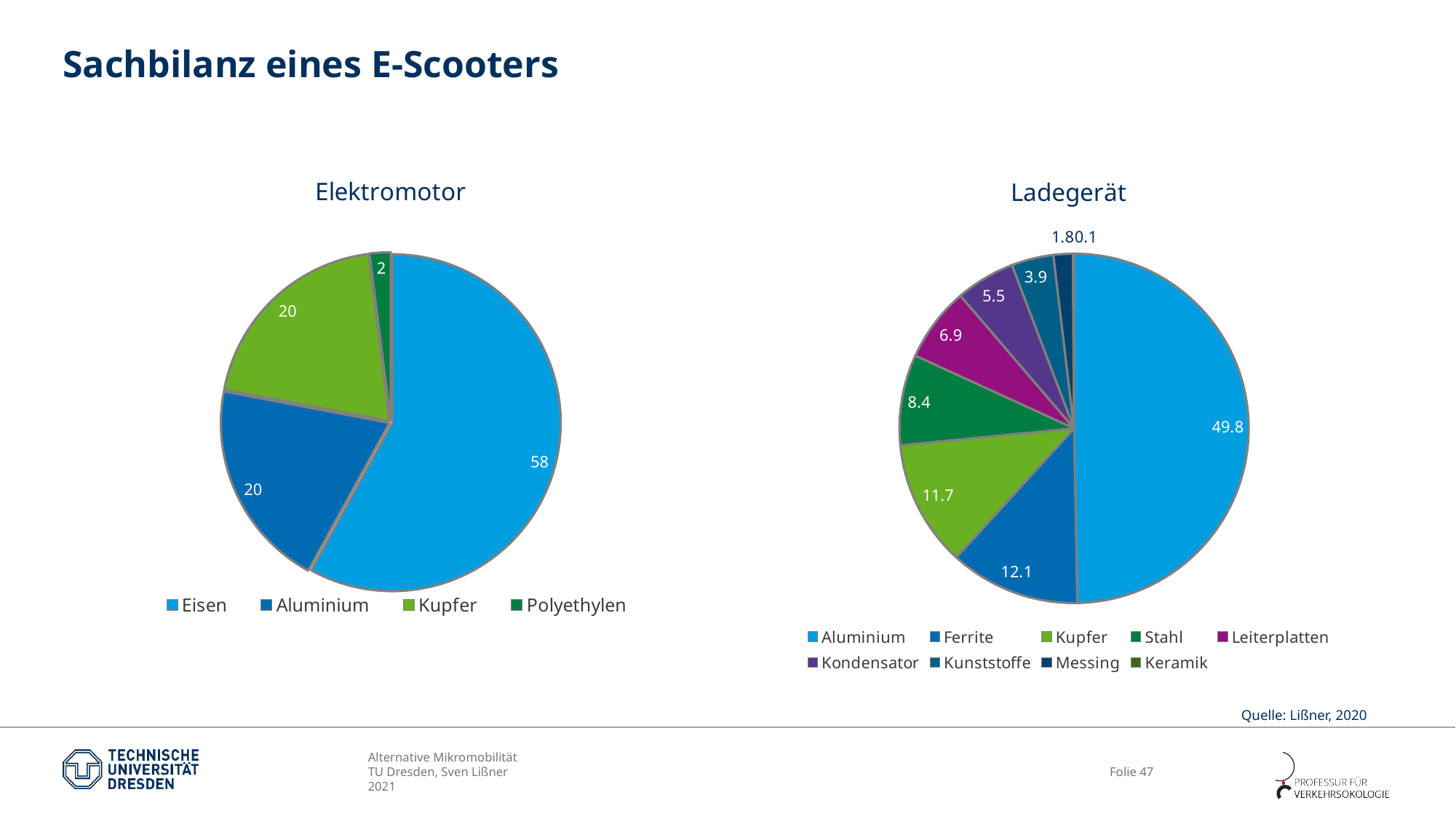
In the Elektromotor chart, which category has the smallest slice? Polyethylen In the Elektromotor chart, what is the value for Eisen? 58 In the Elektromotor chart, what is the value for Polyethylen? 2 In the Elektromotor chart, what is the difference between the values for Eisen and Aluminium? 38 In the Ladegerät chart, which is larger, the value for Ferrite or the value for Kupfer? Ferrite In the Ladegerät chart, what is the difference between the values for Leiterplatten and Kondensator? 1.4 What kind of chart is the Ladegerät chart? Pie chart How many categories does the legend of the Elektromotor chart list? 4 In the Elektromotor chart, which category has the largest slice? Eisen How many categories does the legend of the Ladegerät chart list? 9 In the Ladegerät chart, what is the value for Aluminium? 49.8 In the Ladegerät chart, what is the value for Stahl? 8.4